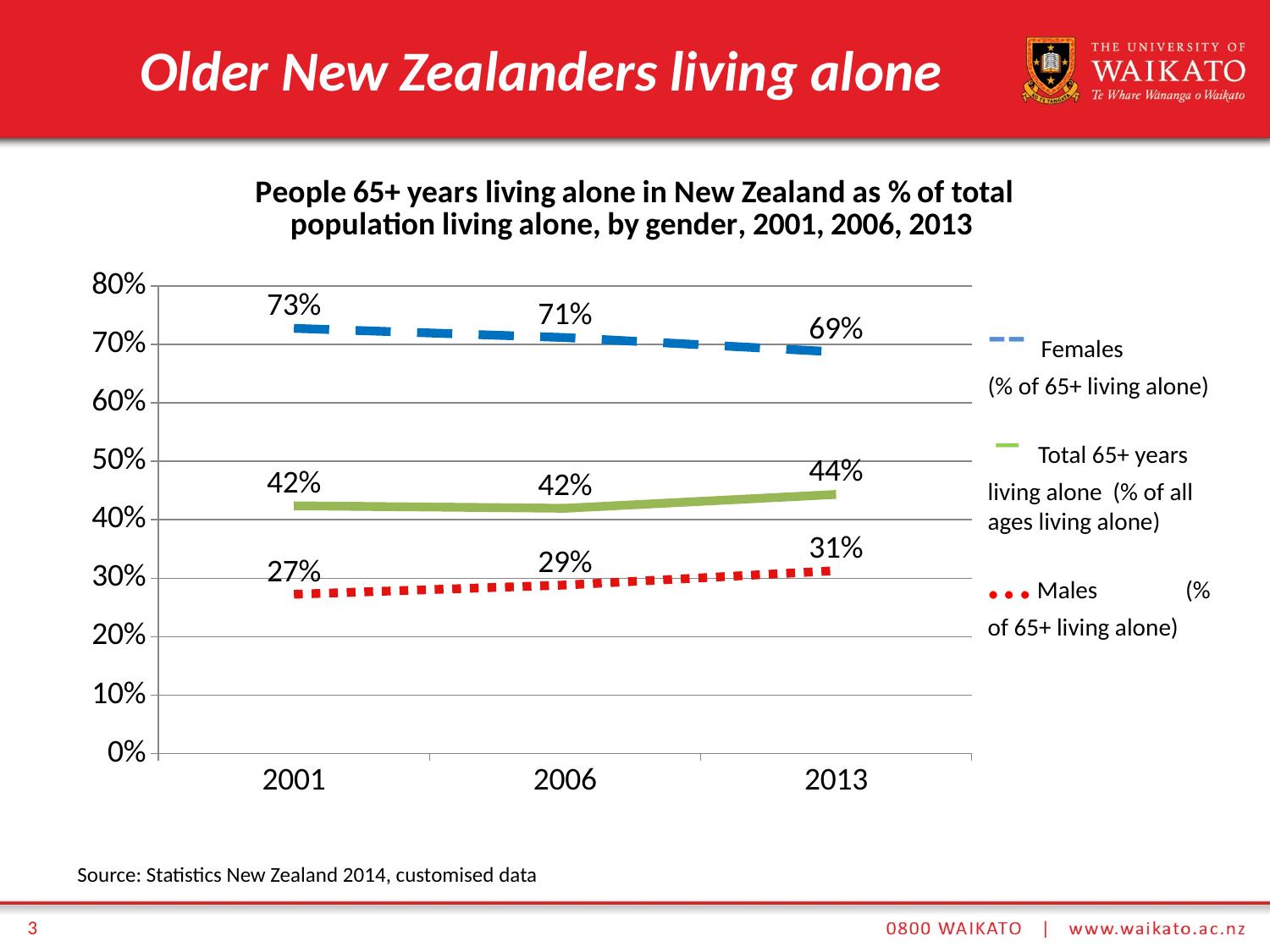
Does the Males series rise or fall from 2001 to 2013? Rise In which year is the Males series highest? 2013 What kind of chart is shown? Line chart What is the difference between the Females and Males values in 2013? 38% In which year is the Females series lowest? 2013 Which is larger in 2006, the Females value or the Total 65+ years living alone value? Females How many years are shown on the x axis? 3 What is the value for Females in 2001? 73% How many series does the legend list? 3 What is the value for Males in 2013? 31% By how much did the Females value fall from 2001 to 2013? 4% What is the value for Total 65+ years living alone in 2006? 42%